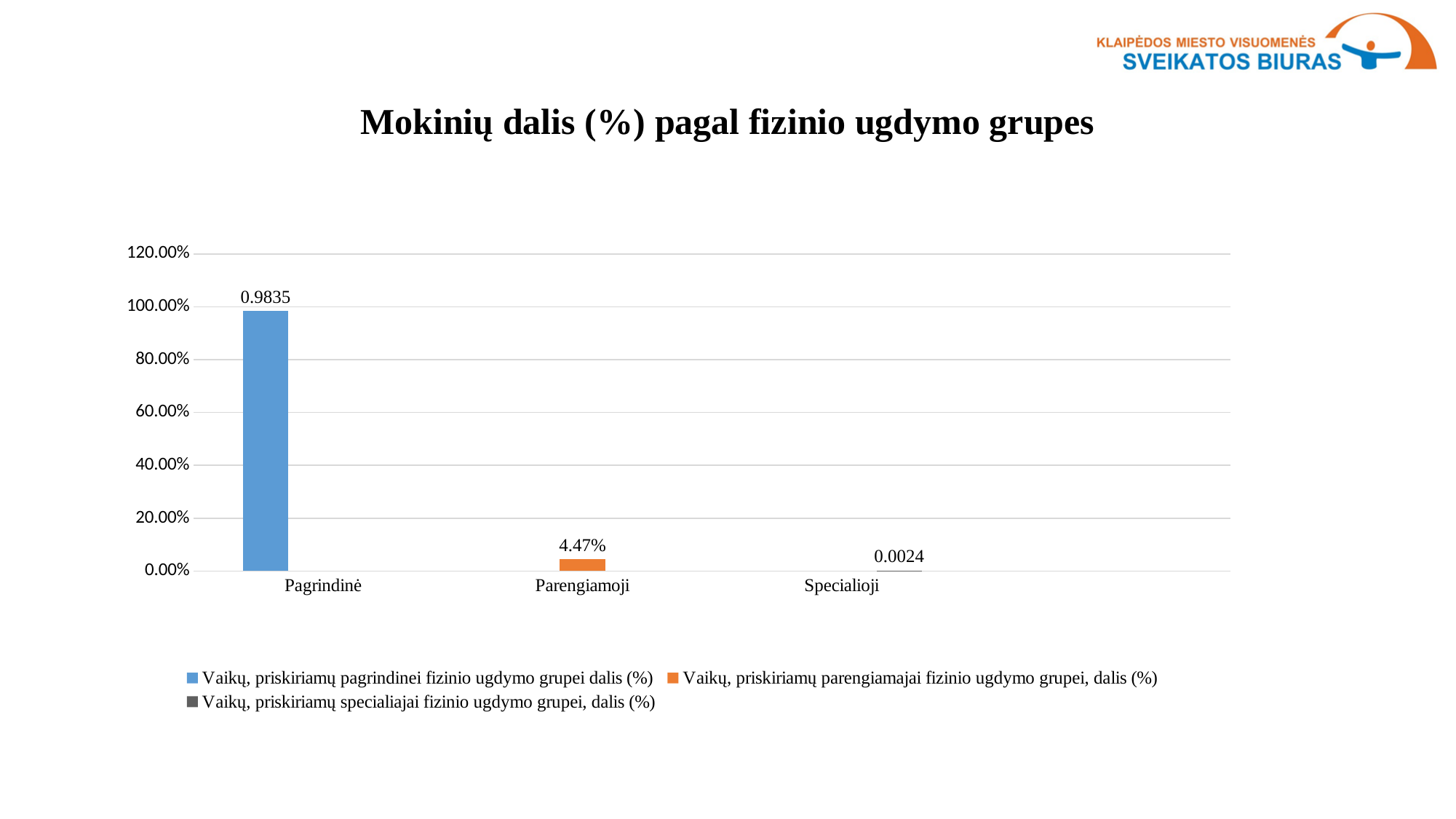
How many categories are shown on the x axis? 3 How many series does the legend list? 3 What is the data label shown on the bar for Parengiamoji? 4.47% Which category has the lowest value? Specialioji What is the title of the chart? Mokinių dalis (%) pagal fizinio ugdymo grupes Is the value for Parengiamoji greater or less than 20.00%? less Which is larger, the value for Pagrindinė or the value for Parengiamoji? Pagrindinė Is the value for Pagrindinė greater or less than 80.00%? greater Which category has the highest bar? Pagrindinė What is the data label shown on the bar for Pagrindinė? 0.9835 What kind of chart is shown on the slide? Bar chart What is the data label shown for Specialioji? 0.0024